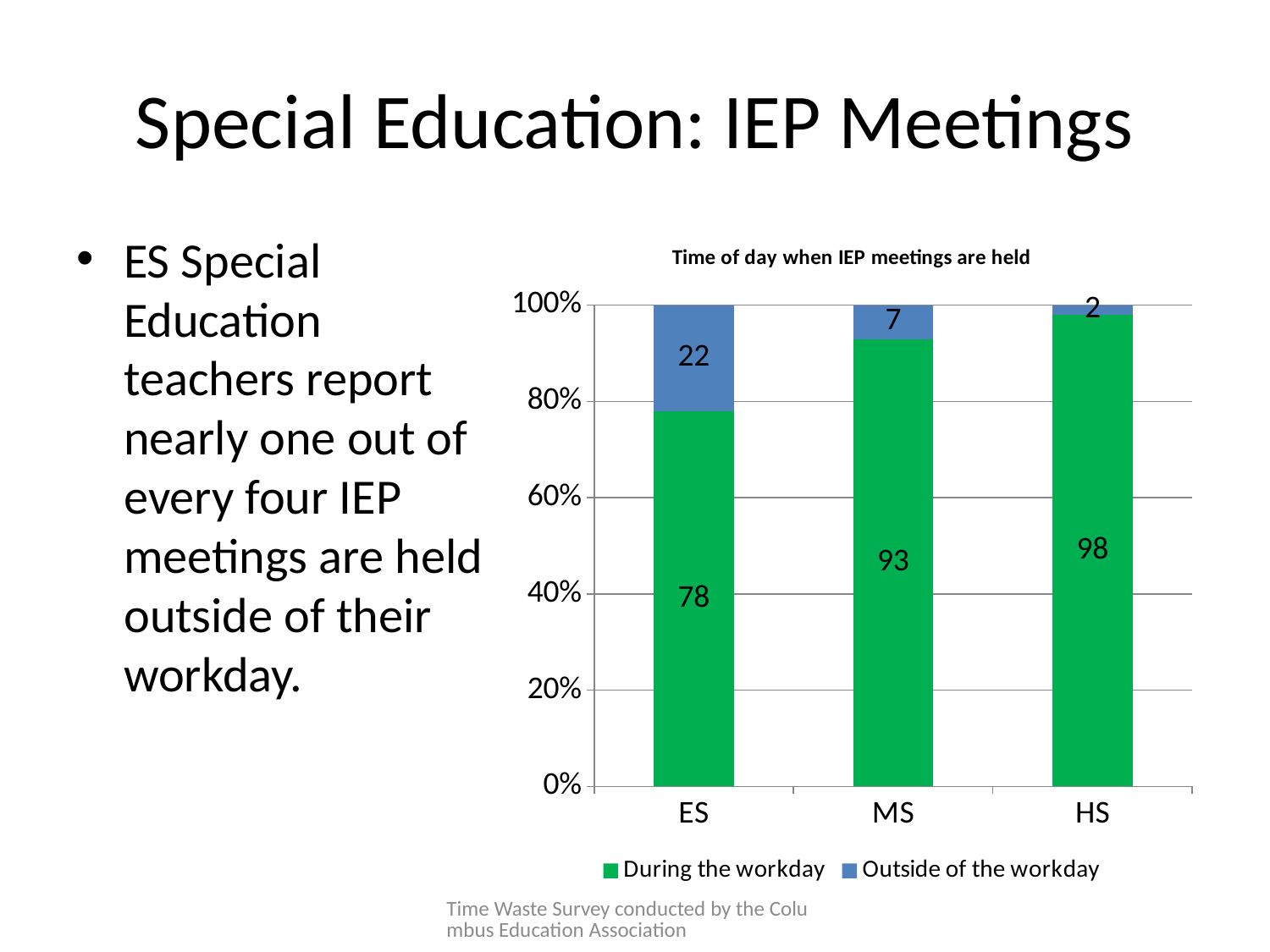
What is the difference between the "Outside of the workday" values for ES and MS? 15 Which category has the lowest value for "Outside of the workday"? HS How many categories are shown on the x axis? 3 What is the title of the chart? Time of day when IEP meetings are held What is the value for "During the workday" for MS? 93 Which is larger: the "During the workday" value for ES or for HS? HS Which category has the highest value for "During the workday"? HS What is the value for "Outside of the workday" for MS? 7 What is the value for "Outside of the workday" for HS? 2 What kind of chart is shown on the slide? Stacked bar chart How many series does the legend list? 2 What is the value for "During the workday" for ES? 78